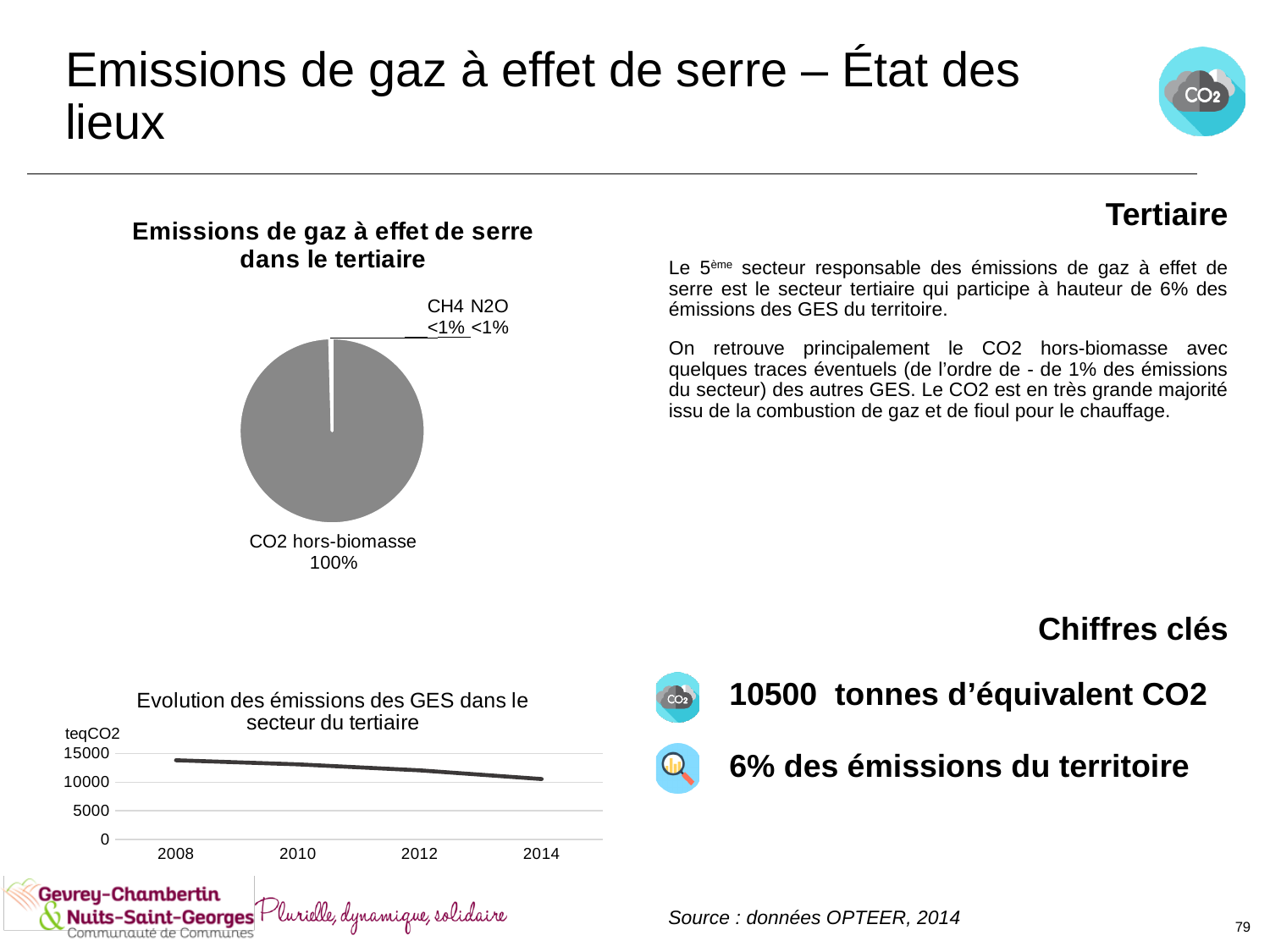
In the pie chart 'Emissions de gaz à effet de serre dans le tertiaire', how many categories are labelled? 3 In the chart 'Evolution des émissions des GES dans le secteur du tertiaire', do the emissions rise or fall from 2008 to 2014? Fall In the pie chart 'Emissions de gaz à effet de serre dans le tertiaire', which category has the largest slice? CO2 hors-biomasse What kind of chart is 'Emissions de gaz à effet de serre dans le tertiaire'? Pie chart In the pie chart 'Emissions de gaz à effet de serre dans le tertiaire', what share is shown for CO2 hors-biomasse? 100% In the chart 'Evolution des émissions des GES dans le secteur du tertiaire', is the value for 2008 greater or less than 10000? greater In the chart 'Evolution des émissions des GES dans le secteur du tertiaire', which year has the higher value, 2008 or 2014? 2008 What kind of chart is 'Evolution des émissions des GES dans le secteur du tertiaire'? Line chart In the chart 'Evolution des émissions des GES dans le secteur du tertiaire', is the value for 2014 greater or less than 15000? less In the pie chart 'Emissions de gaz à effet de serre dans le tertiaire', what share is shown for N2O? <1% In the pie chart 'Emissions de gaz à effet de serre dans le tertiaire', what share is shown for CH4? <1% In the chart 'Evolution des émissions des GES dans le secteur du tertiaire', what unit is shown on the y axis? teqCO2